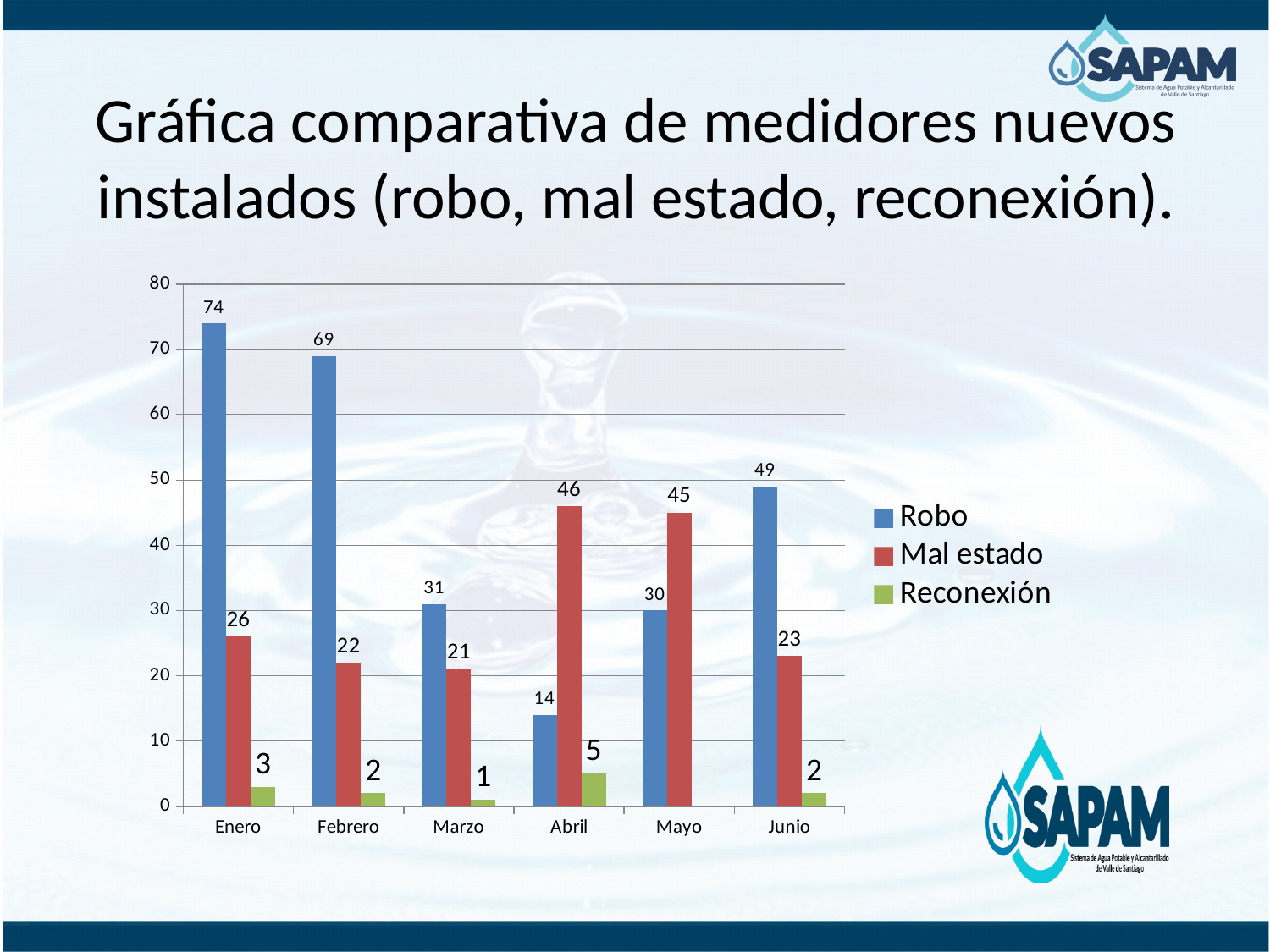
What is the Robo value for Enero? 74 How many series does the legend list? 3 What is the Mal estado value for Abril? 46 Which month has the lowest Robo value? Abril How many months are shown on the x axis? 6 Which month has the highest Robo value? Enero Is the Robo value for Junio greater or less than 40? greater Which is larger in Mayo, Robo or Mal estado? Mal estado Which colour represents the Reconexión series? green What kind of chart is shown on the slide? bar chart What is the difference between the Robo values for Enero and Febrero? 5